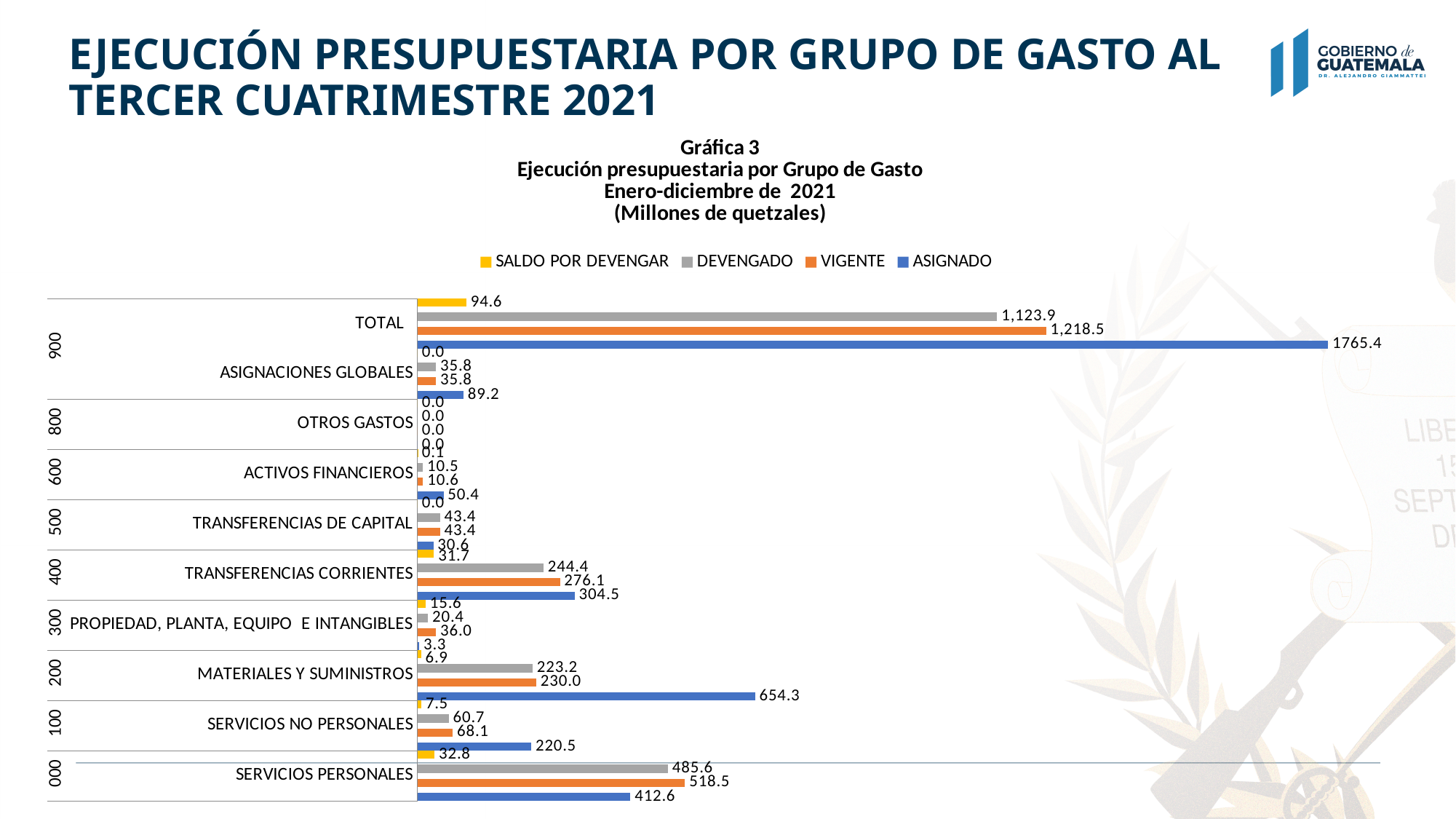
How many series does the legend list? 4 What kind of chart is shown on the slide? Bar chart What is the DEVENGADO value for SERVICIOS PERSONALES? 485.6 What is the difference between the VIGENTE and DEVENGADO values for SERVICIOS NO PERSONALES? 7.4 Which is larger for SERVICIOS PERSONALES, the VIGENTE value or the ASIGNADO value? VIGENTE Excluding TOTAL, which category has the highest ASIGNADO value? MATERIALES Y SUMINISTROS What is the VIGENTE value for TRANSFERENCIAS CORRIENTES? 276.1 Excluding TOTAL, which category has the highest DEVENGADO value? SERVICIOS PERSONALES What is the ASIGNADO value for MATERIALES Y SUMINISTROS? 654.3 Which colour represents the ASIGNADO series in the legend? Blue What is the SALDO POR DEVENGAR value for TOTAL? 94.6 How many categories are shown on the chart, including TOTAL? 10